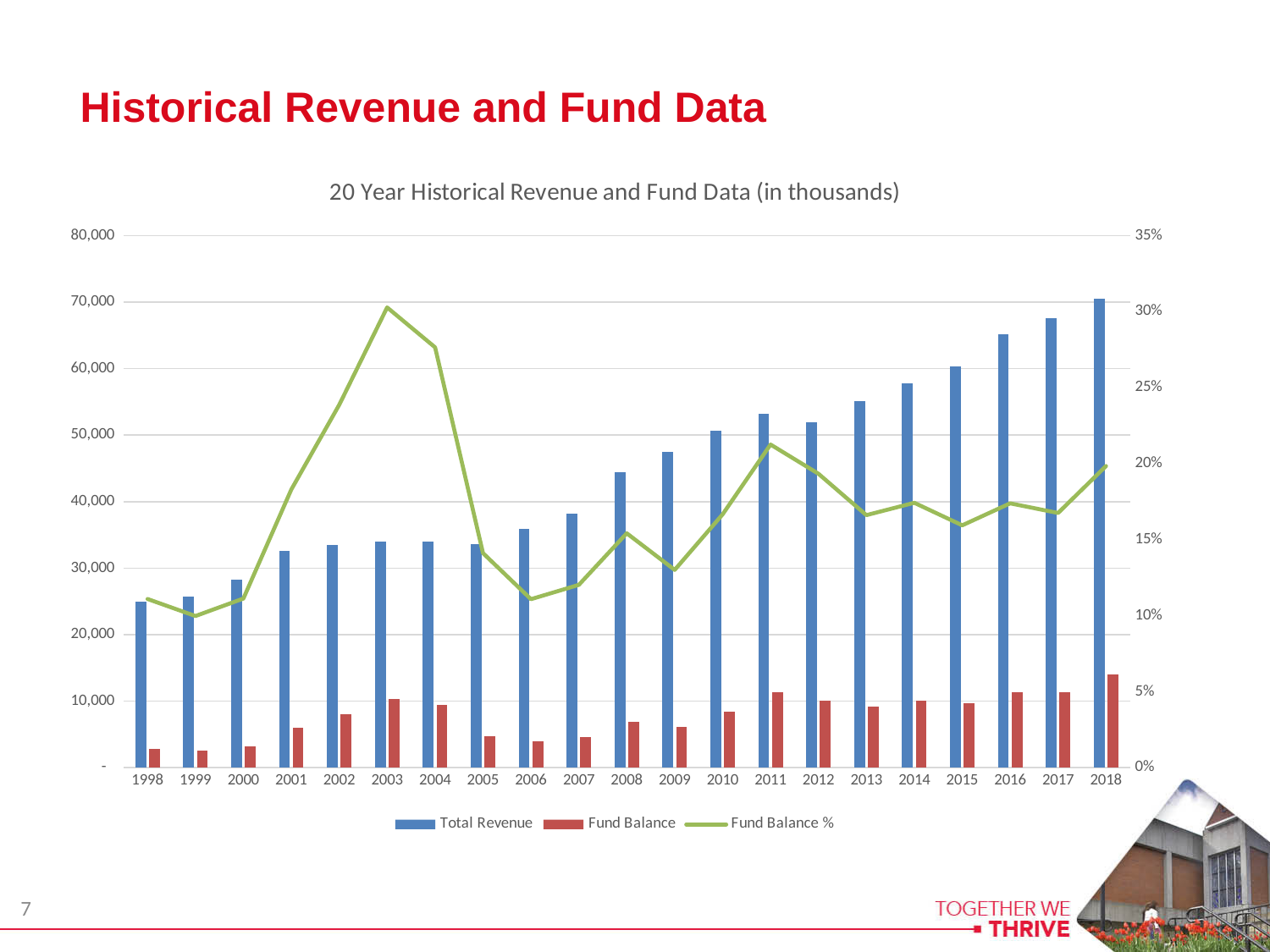
Which year has the larger Total Revenue, 2003 or 2008? 2008 What is the title of the chart? 20 Year Historical Revenue and Fund Data (in thousands) What kind of chart is shown on the slide? A combined bar and line chart Is the Fund Balance % for 2006 greater or less than 15%? less Does Total Revenue generally rise or fall from 1998 to 2018? rise In which year does the Fund Balance % line reach its peak? 2003 Is the Total Revenue for 1998 greater or less than 30,000? less How many series does the legend list? 3 Which year has the highest Fund Balance? 2018 How many years are shown on the x axis? 21 Which year has the highest Total Revenue? 2018 Is the Total Revenue for 2018 greater or less than 60,000? greater